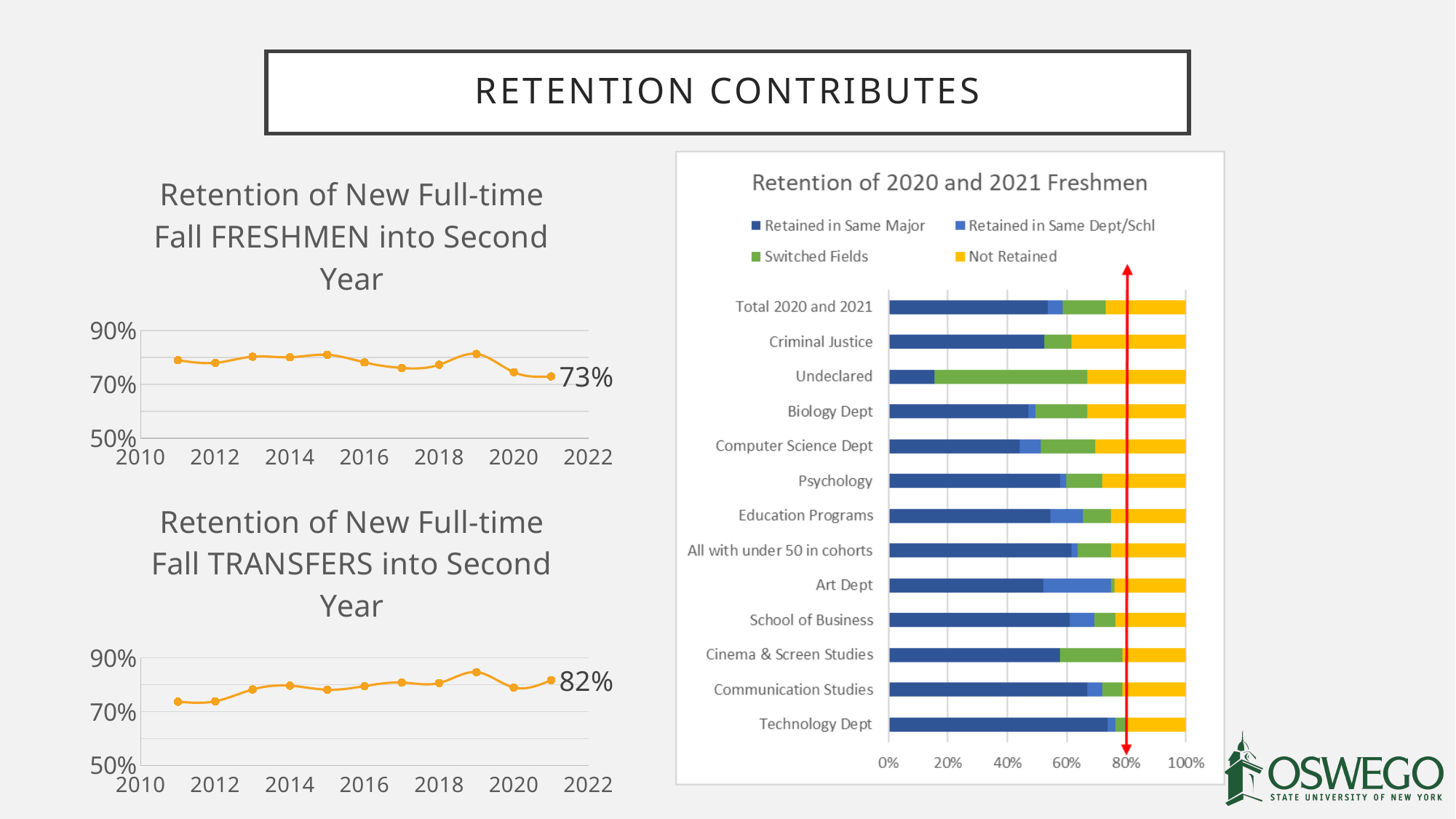
How many series does the legend of the 'Retention of 2020 and 2021 Freshmen' chart list? 4 What kind of chart is the 'Retention of 2020 and 2021 Freshmen' chart? Stacked bar chart In the 'Retention of 2020 and 2021 Freshmen' chart, which category has the largest 'Switched Fields' segment? Undeclared Comparing the labeled 2021 values, which is higher: freshmen retention or transfer retention? Transfer retention (82%) In the 'Retention of New Full-time Fall TRANSFERS into Second Year' chart, what is the labeled retention value for 2021? 82% In the 'Retention of 2020 and 2021 Freshmen' chart, which category has the smallest 'Not Retained' segment? Technology Dept How many categories are shown on the 'Retention of 2020 and 2021 Freshmen' chart? 13 In the 'Retention of 2020 and 2021 Freshmen' chart, is the 'Retained in Same Major' value for Undeclared greater or less than 20%? less What is the difference between the labeled 2021 transfer retention (82%) and the labeled 2021 freshmen retention (73%)? 9 percentage points In the 'Retention of New Full-time Fall FRESHMEN into Second Year' chart, what is the labeled retention value for 2021? 73% What kind of chart is the 'Retention of New Full-time Fall FRESHMEN into Second Year' chart? Line chart In the 'Retention of New Full-time Fall FRESHMEN into Second Year' chart, does the line rise or fall from 2019 to 2021? Fall